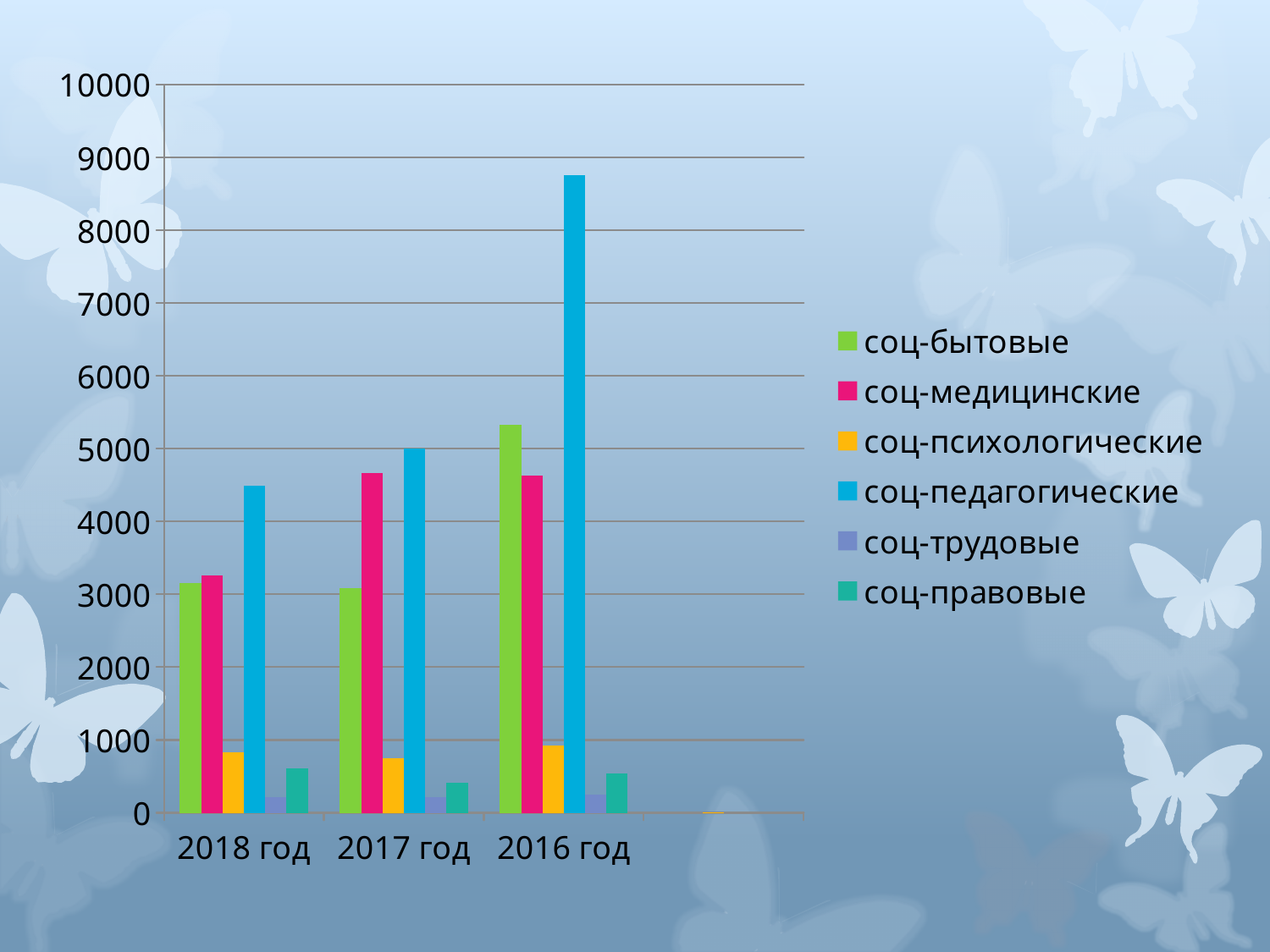
Is the value for соц-бытовые in 2018 год greater or less than 4000? less Which is larger: соц-бытовые in 2016 год or соц-бытовые in 2018 год? 2016 год Is the value for соц-педагогические in 2016 год greater or less than 8000? greater Which year has the highest value for соц-педагогические? 2016 год Which series has the highest value in 2016 год? соц-педагогические Do the values for соц-педагогические rise or fall moving left to right along the x axis from 2018 год to 2016 год? rise Is the value for соц-психологические in 2016 год greater or less than 1000? less In 2017 год, which is larger: соц-медицинские or соц-бытовые? соц-медицинские What kind of chart is shown on the slide? bar chart How many series does the legend list? 6 How many years are labelled on the x axis? 3 Which series has the lowest value in 2018 год? соц-трудовые